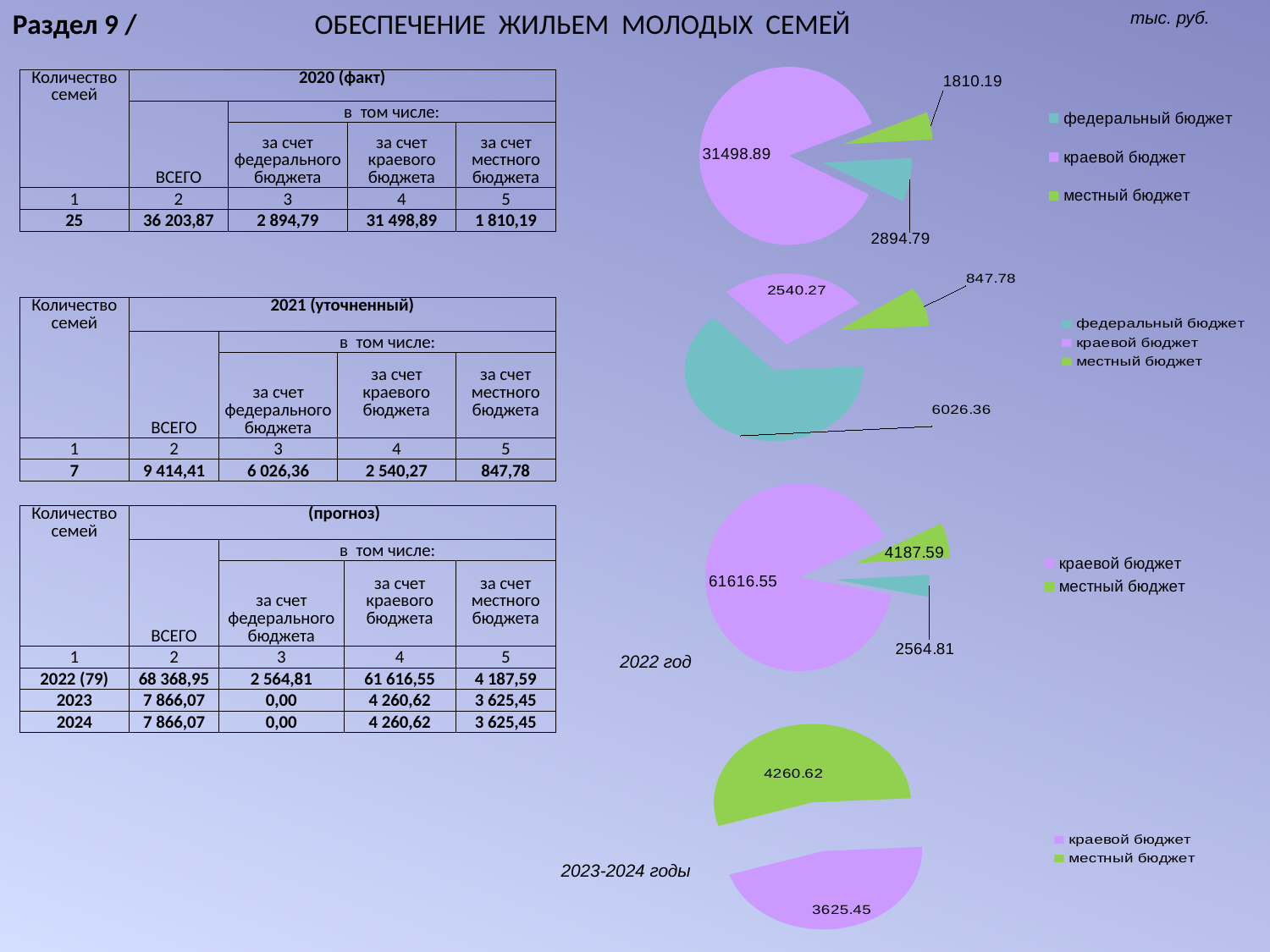
In the top pie chart, what is the value of the smallest slice? 1810.19 In the top pie chart, what is the total of all three slice values? 36203.87 What kind of chart is the top chart on the right side of the slide? pie chart How many entries does the legend of the top pie chart list? 3 How many entries does the legend of the pie chart labelled 2022 год list? 2 In the pie chart labelled 2022 год, what is the value of the largest slice? 61616.55 How many slices does the top pie chart have? 3 In the second pie chart from the top, what is the difference between the slice labelled 6026.36 and the slice labelled 2540.27? 3486.09 In the second pie chart from the top, what is the value of the largest slice? 6026.36 In the pie chart labelled 2023-2024 годы, what is the difference between the two slice values? 635.17 In the top pie chart, what is the value of the largest slice? 31498.89 In the pie chart labelled 2022 год, which is larger: the slice labelled 4187.59 or the slice labelled 2564.81? 4187.59